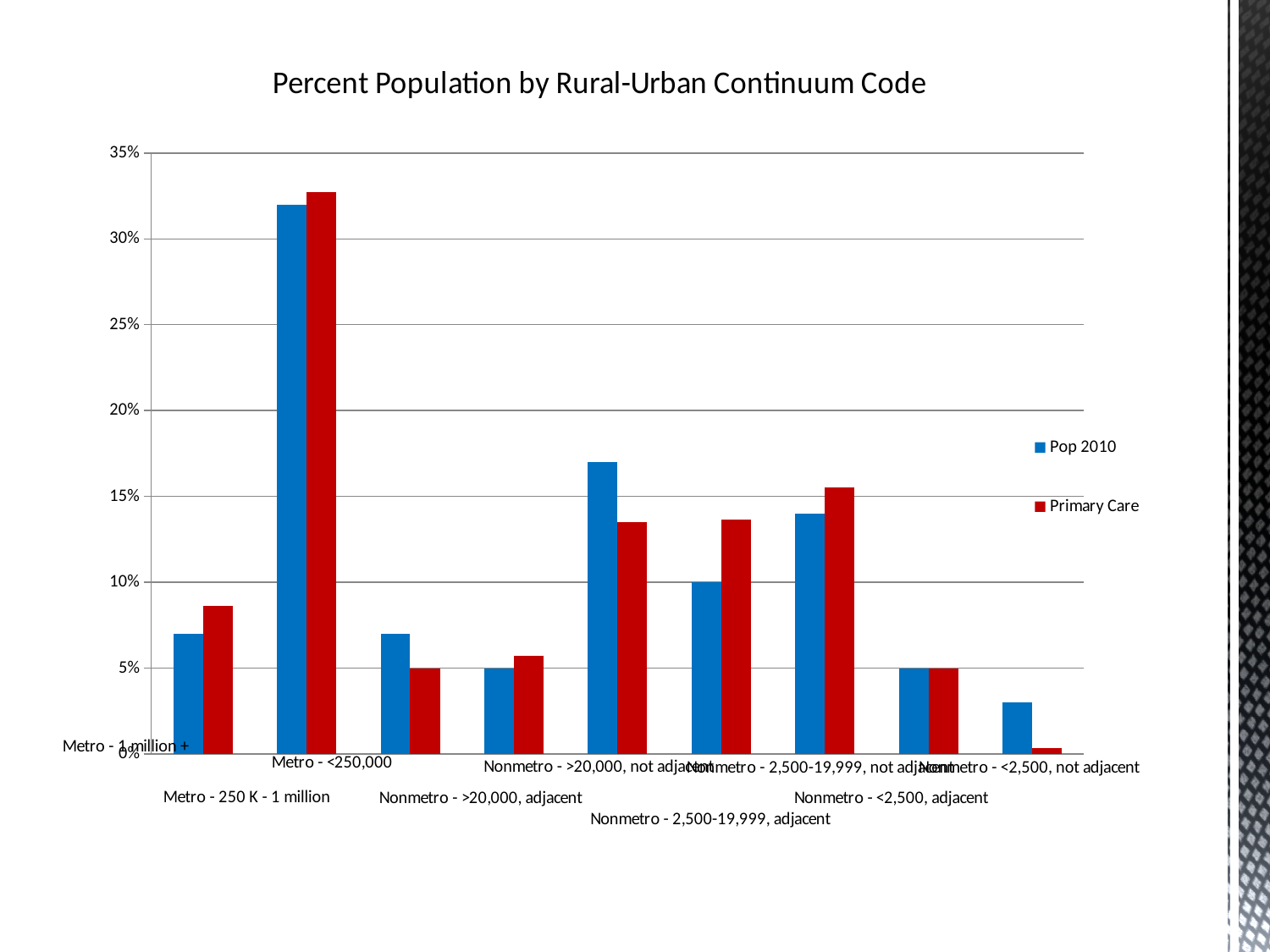
Is the Pop 2010 value for Metro - 250 K - 1 million greater or less than 30%? greater What is the Pop 2010 value for Nonmetro - 2,500-19,999, adjacent? 10% For Nonmetro - 2,500-19,999, adjacent, which series has the larger value, Pop 2010 or Primary Care? Primary Care How many categories are shown on the x axis? 9 Is the Pop 2010 value for Nonmetro - >20,000, not adjacent greater or less than 15%? greater Is the Primary Care value for Metro - 1 million + greater or less than 10%? less Which colour represents the Primary Care series in the legend? red Which category has the lowest Primary Care value? Nonmetro - <2,500, not adjacent Which category has the highest Pop 2010 value? Metro - 250 K - 1 million What kind of chart is shown on the slide? bar chart How many series does the legend list? 2 For Nonmetro - >20,000, not adjacent, which series has the larger value, Pop 2010 or Primary Care? Pop 2010